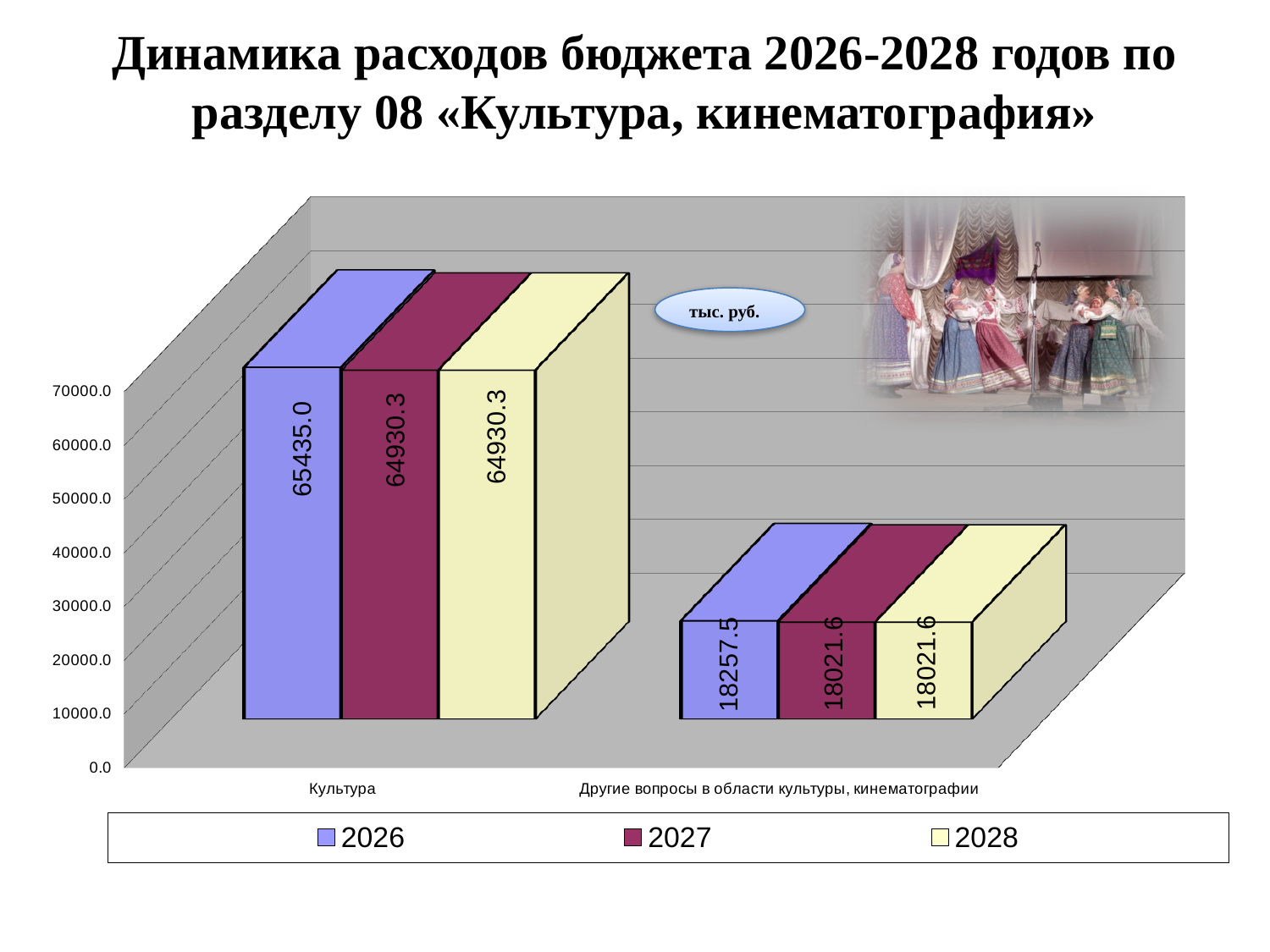
What is the difference between the 2026 and 2028 values for Другие вопросы в области культуры, кинематографии? 235.9 Which is larger: the 2026 value for Культура or the 2026 value for Другие вопросы в области культуры, кинематографии? Культура How many categories are shown on the x axis? 2 Which category has the lowest value in 2027? Другие вопросы в области культуры, кинематографии Which category has the highest value in 2026? Культура What is the value for Культура in 2026? 65435.0 What is the value for Культура in 2027? 64930.3 What is the difference between the 2026 and 2027 values for Культура? 504.7 What kind of chart is shown on the slide? Bar chart What is the value for Другие вопросы в области культуры, кинематографии in 2028? 18021.6 What is the value for Другие вопросы в области культуры, кинематографии in 2026? 18257.5 How many series does the legend list? 3